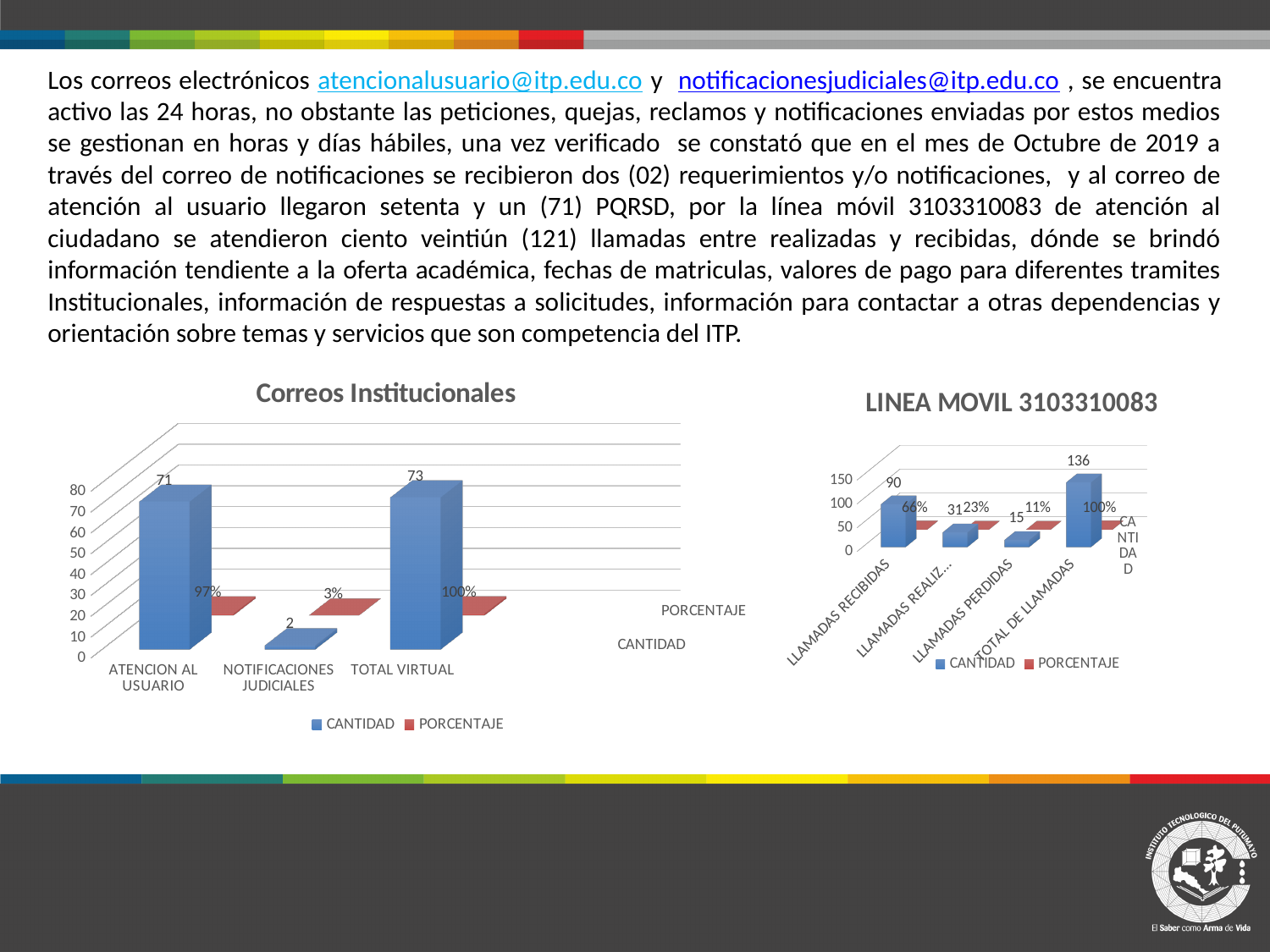
In the 'Correos Institucionales' chart, how many series does the legend list? 2 In the 'Correos Institucionales' chart, what is the CANTIDAD value for ATENCION AL USUARIO? 71 In the 'LINEA MOVIL 3103310083' chart, what is the CANTIDAD value for TOTAL DE LLAMADAS? 136 What kind of chart is 'Correos Institucionales'? Bar chart In the 'LINEA MOVIL 3103310083' chart, is the CANTIDAD value for LLAMADAS RECIBIDAS greater or less than the CANTIDAD value for LLAMADAS PERDIDAS? greater In the 'LINEA MOVIL 3103310083' chart, what is the PORCENTAJE value for LLAMADAS PERDIDAS? 11% In the 'LINEA MOVIL 3103310083' chart, which category has the highest CANTIDAD value? TOTAL DE LLAMADAS In the 'Correos Institucionales' chart, what is the PORCENTAJE value for NOTIFICACIONES JUDICIALES? 3% In the 'LINEA MOVIL 3103310083' chart, how many categories are shown on the x axis? 4 In the 'Correos Institucionales' chart, which category has the lowest CANTIDAD value? NOTIFICACIONES JUDICIALES In the 'LINEA MOVIL 3103310083' chart, what is the CANTIDAD value for LLAMADAS RECIBIDAS? 90 In the 'Correos Institucionales' chart, what is the difference between the CANTIDAD values for TOTAL VIRTUAL and ATENCION AL USUARIO? 2